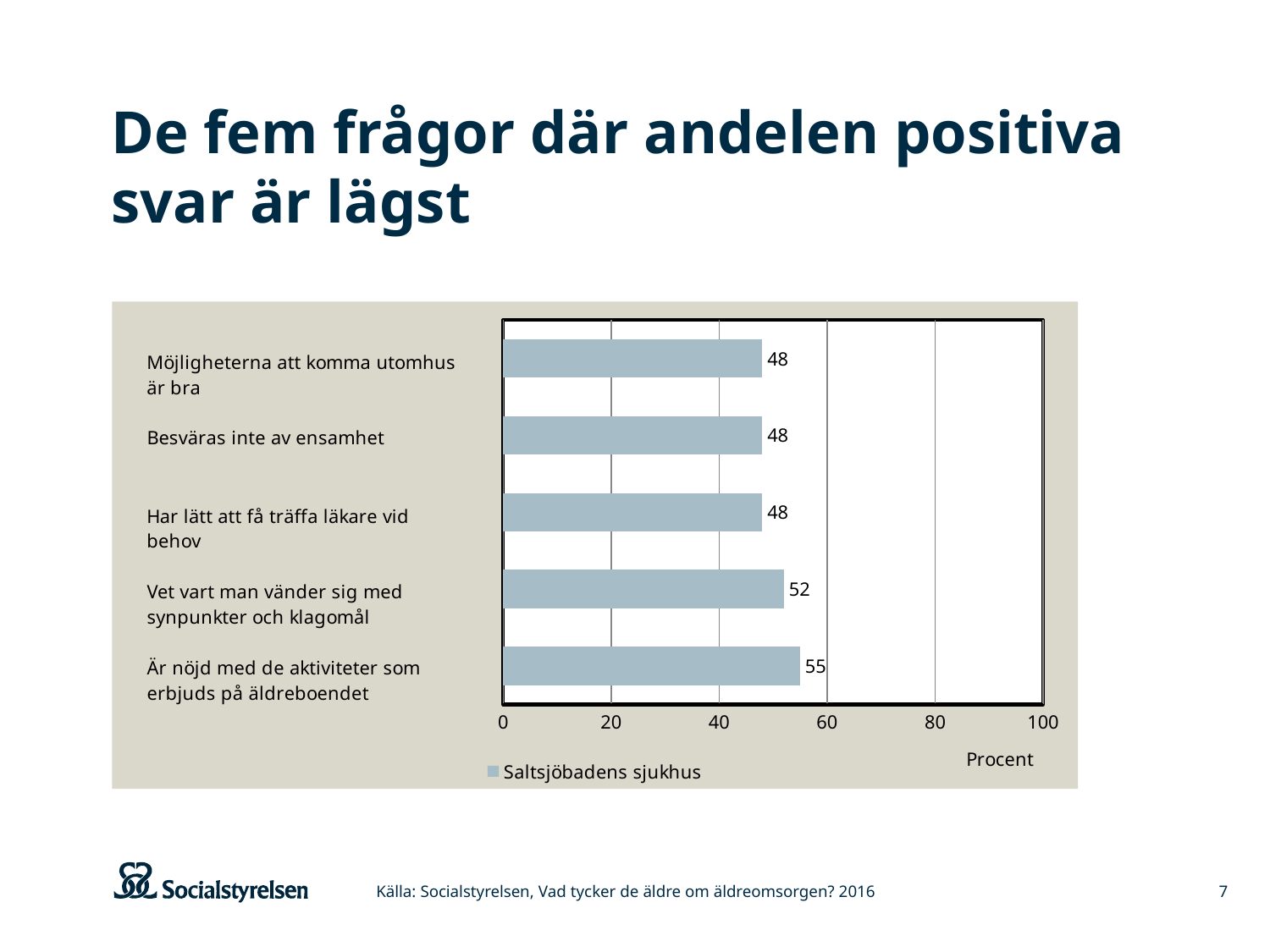
What value is shown for "Är nöjd med de aktiviteter som erbjuds på äldreboendet"? 55 What kind of chart is shown on the slide? bar chart How many series does the legend list? 1 What series name is shown in the chart legend? Saltsjöbadens sjukhus What value is shown for "Besväras inte av ensamhet"? 48 What value is shown for "Vet vart man vänder sig med synpunkter och klagomål"? 52 What is the difference between the values for "Är nöjd med de aktiviteter som erbjuds på äldreboendet" and "Vet vart man vänder sig med synpunkter och klagomål"? 3 What is the difference between the values for "Är nöjd med de aktiviteter som erbjuds på äldreboendet" and "Har lätt att få träffa läkare vid behov"? 7 How many categories are shown in the chart? 5 Which category has the highest value? Är nöjd med de aktiviteter som erbjuds på äldreboendet Which is larger: the value for "Vet vart man vänder sig med synpunkter och klagomål" or the value for "Möjligheterna att komma utomhus är bra"? Vet vart man vänder sig med synpunkter och klagomål Is the value for "Är nöjd med de aktiviteter som erbjuds på äldreboendet" greater or less than 60? less